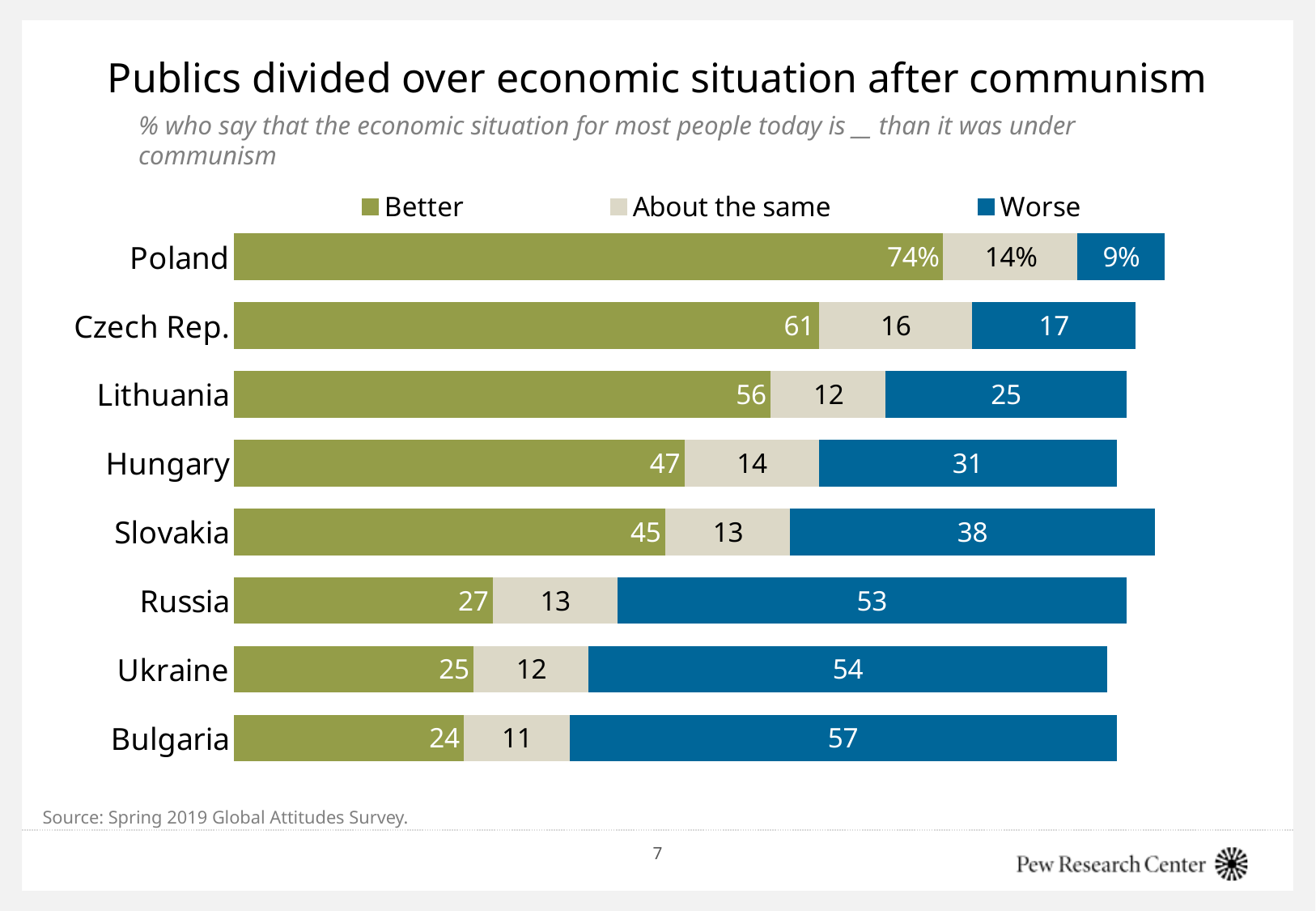
What is the 'About the same' value for the Czech Rep.? 16 Which is larger: the 'Worse' value for Slovakia or the 'Worse' value for Lithuania? Slovakia Which country has the highest 'Worse' value? Bulgaria What is the title of the chart? Publics divided over economic situation after communism What kind of chart is shown on the slide? Stacked bar chart What is the difference between the 'Better' values for Poland and Hungary? 27 What is the total of the three segments for Ukraine? 91 How many series does the legend list? 3 What percentage of people in Poland say the economic situation is better than under communism? 74% How many countries are shown in the chart? 8 What is the 'Worse' value for Russia? 53 Which country has the lowest 'Better' value? Bulgaria